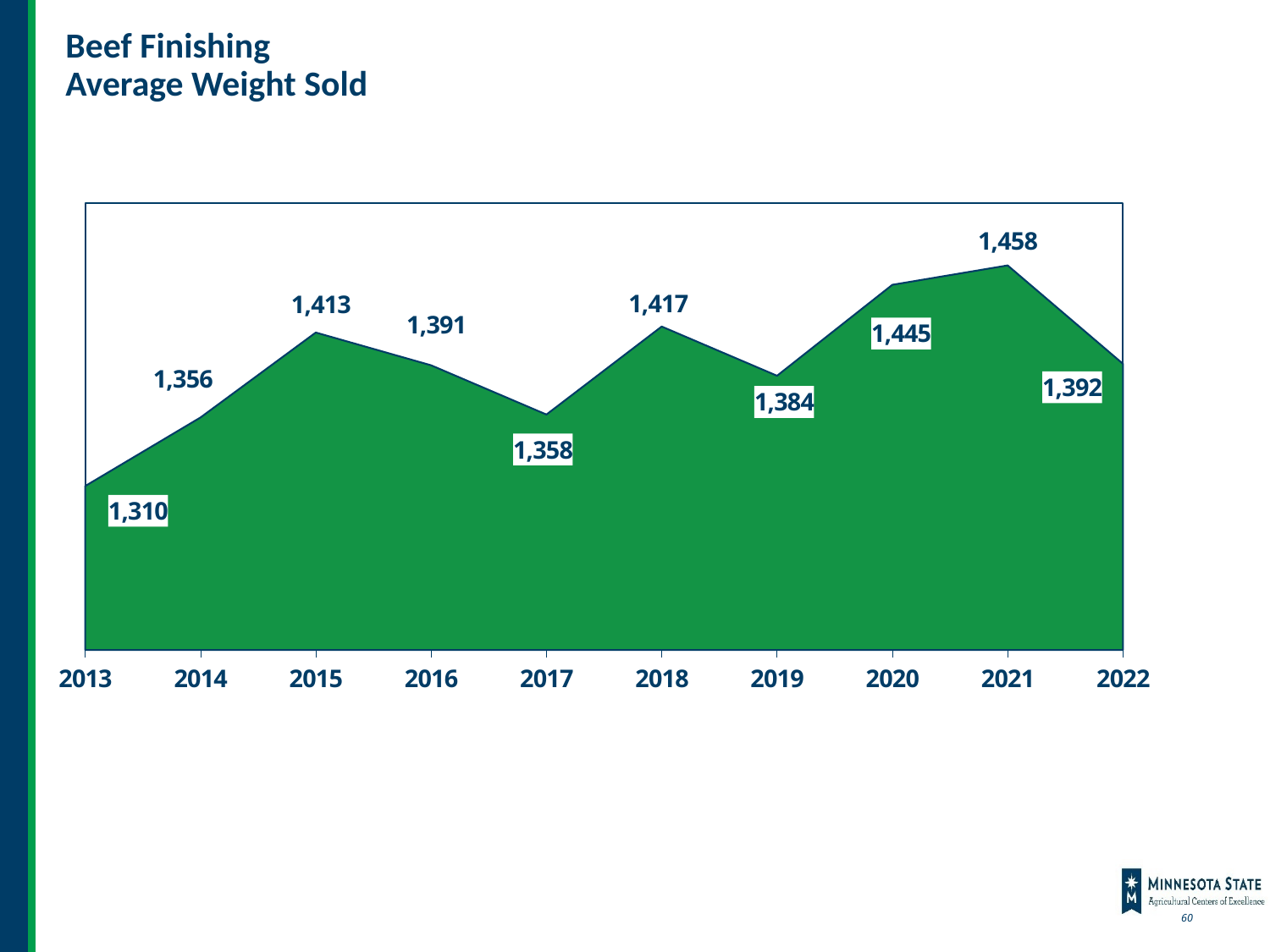
What is the average weight sold in 2013? 1,310 How many years are shown on the x axis? 10 Does the average weight sold rise or fall from 2019 to 2021? Rise What kind of chart is shown on the slide? Area chart What is the difference between the average weight sold in 2021 and in 2013? 148 What is the average weight sold in 2021? 1,458 Which year has the lowest average weight sold? 2013 Which year has a higher average weight sold, 2015 or 2016? 2015 What is the average weight sold in 2022? 1,392 Which year has the highest average weight sold? 2021 What is the difference between the average weight sold in 2022 and in 2021? 66 What is the average weight sold in 2017? 1,358